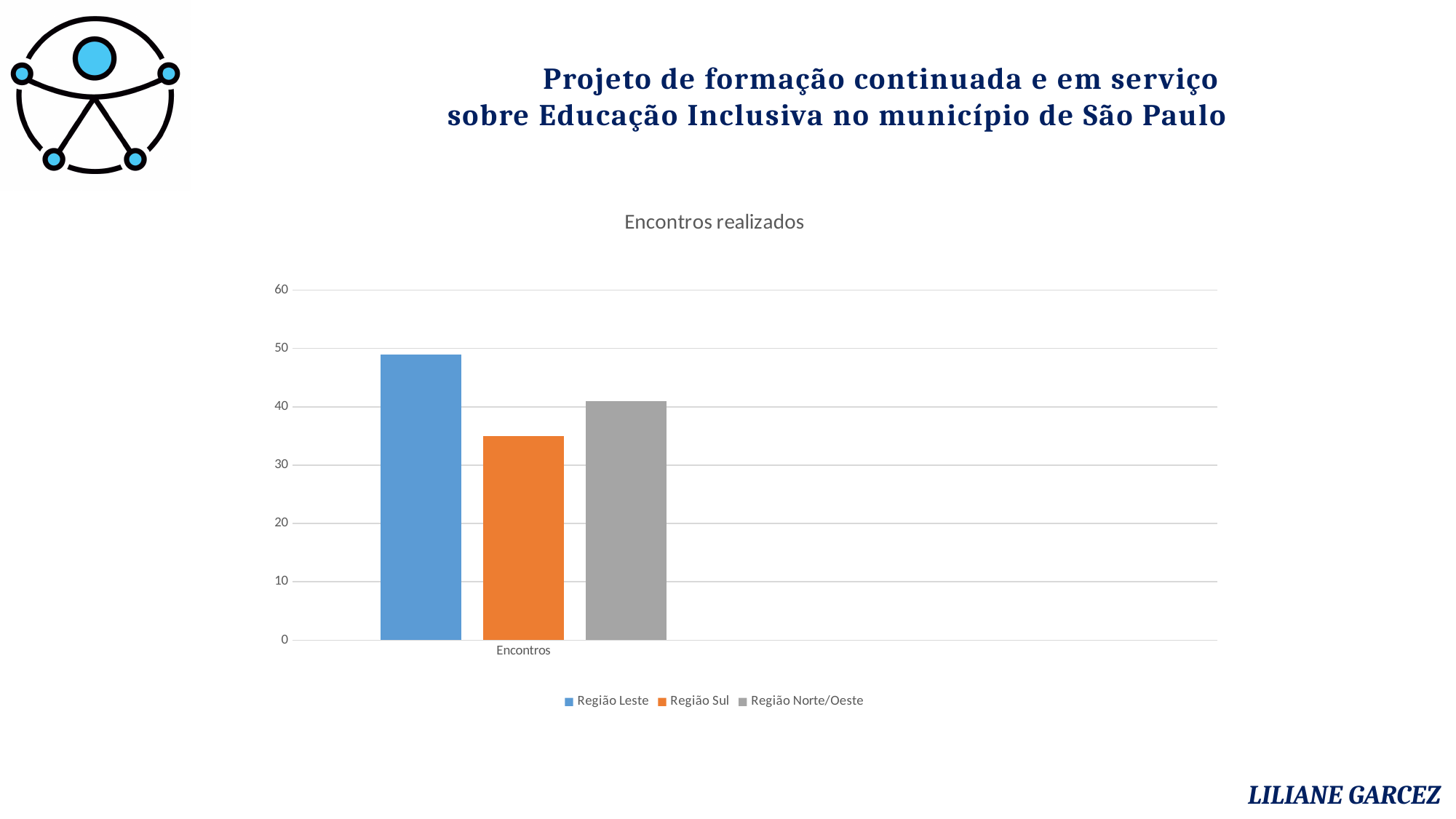
How many series does the legend list? 3 What type of chart is shown on the slide? bar chart Which region has the highest number of encontros? Região Leste What colour is the bar for Região Sul? orange Is the value for Região Norte/Oeste greater or less than 50? less Is the value for Região Sul greater or less than 30? greater Which region has the lowest number of encontros? Região Sul Which is larger, the value for Região Leste or Região Sul? Região Leste Which is larger, the value for Região Norte/Oeste or Região Sul? Região Norte/Oeste Is the value for Região Leste greater or less than 40? greater What is the title of the chart? Encontros realizados